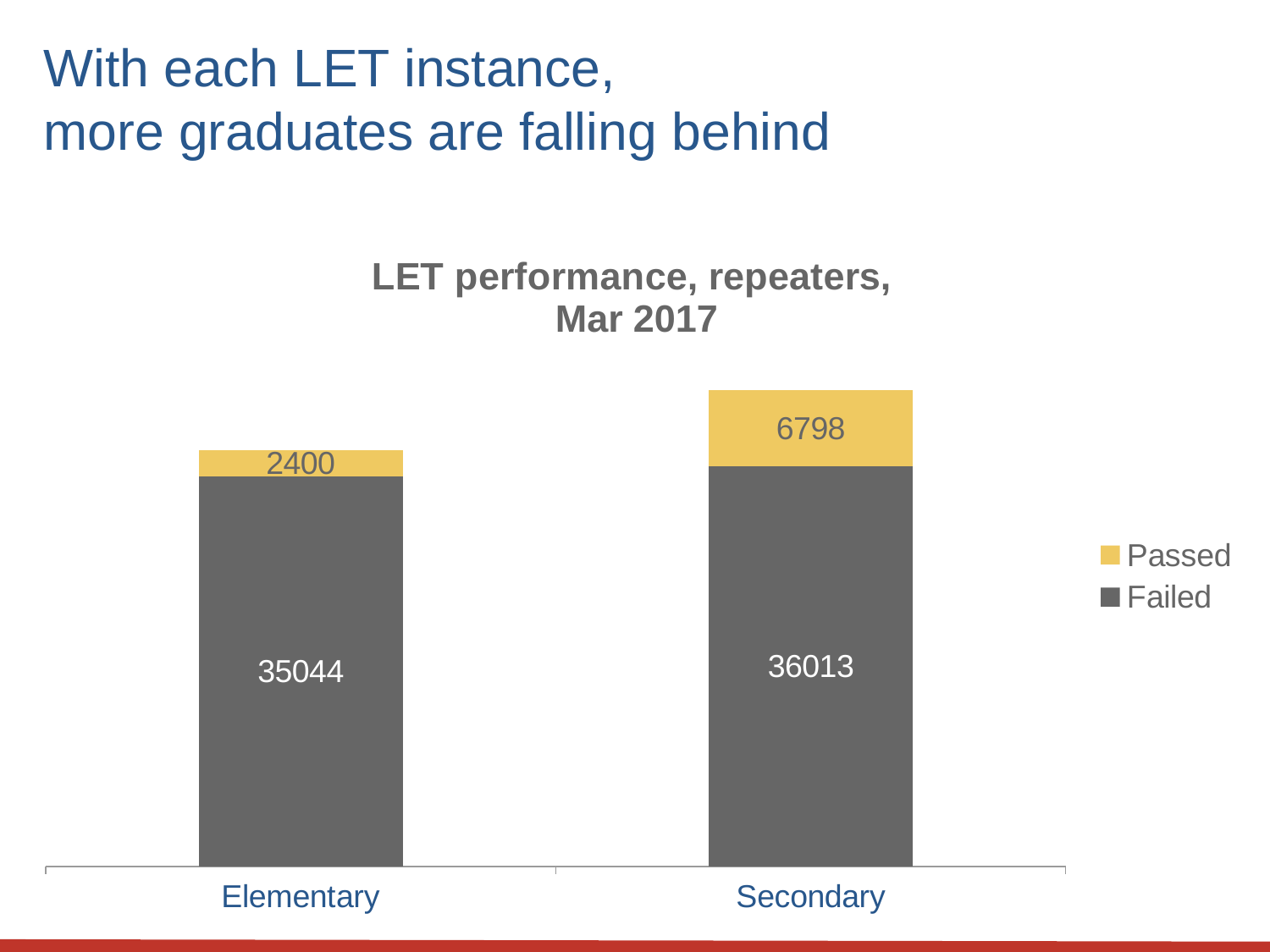
How many categories are shown on the x axis? 2 What is the Failed value for Secondary? 36013 What is the difference between the Passed values for Secondary and Elementary? 4398 What is the Passed value for Elementary? 2400 Which category has the higher Passed value? Secondary What is the Passed value for Secondary? 6798 What kind of chart is shown? Stacked bar chart What is the total of the stacked bar for Elementary? 37444 Which category has the lower Failed value? Elementary How many series does the legend list? 2 What is the Failed value for Elementary? 35044 What is the total of the stacked bar for Secondary? 42811